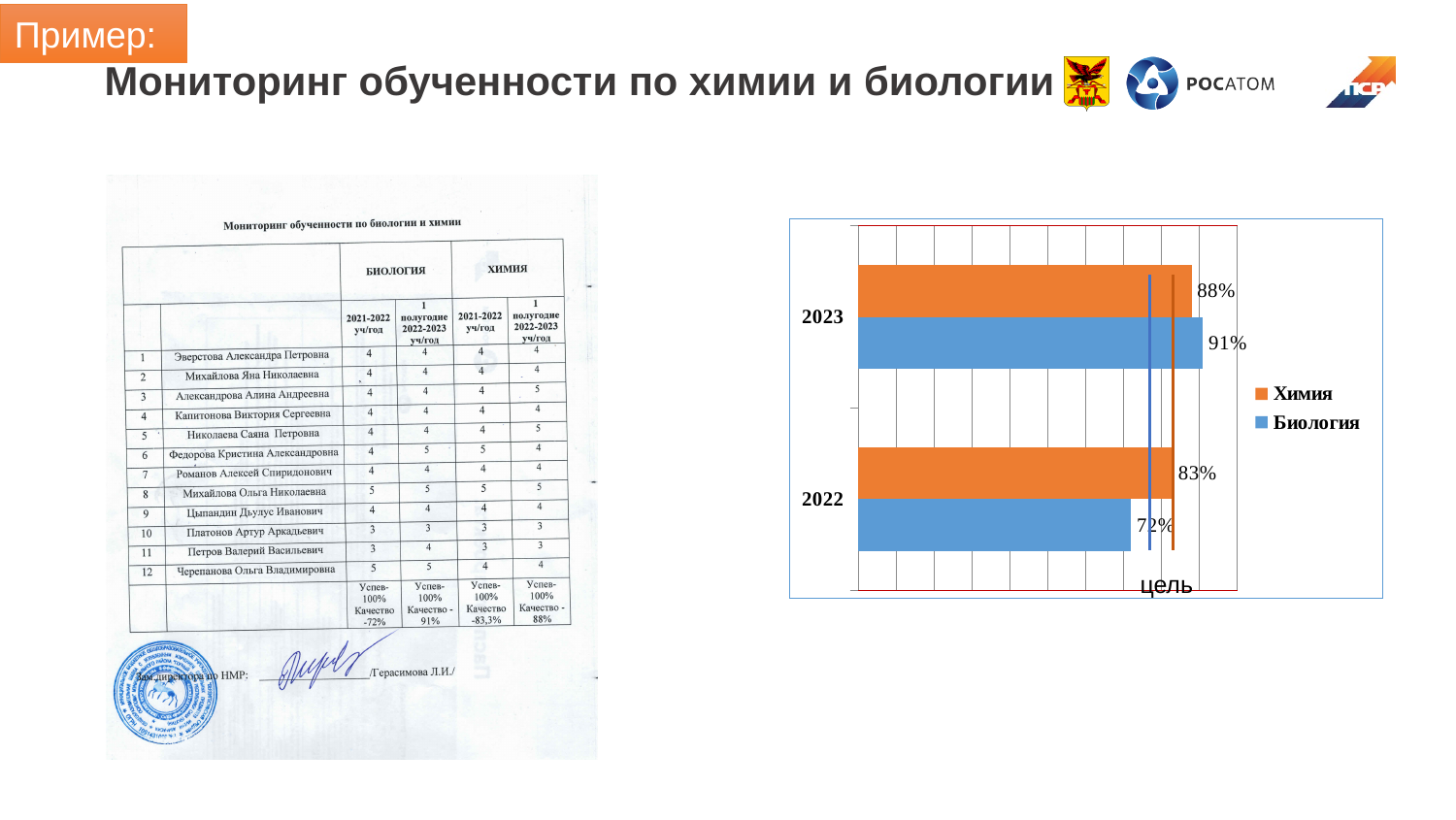
What is the difference between the Биология values for 2023 and 2022? 19% Which colour represents Биология in the chart? blue What is the value for Химия in 2022? 83% What is the value for Биология in 2022? 72% Which bar has the lowest value on the chart? Биология 2022 In 2022, which is larger: Химия or Биология? Химия What is the difference between the Химия values for 2023 and 2022? 5% What kind of chart is shown on the slide? bar chart What is the value for Биология in 2023? 91% What is the value for Химия in 2023? 88% How many series does the legend list? 2 Which bar has the highest value on the chart? Биология 2023